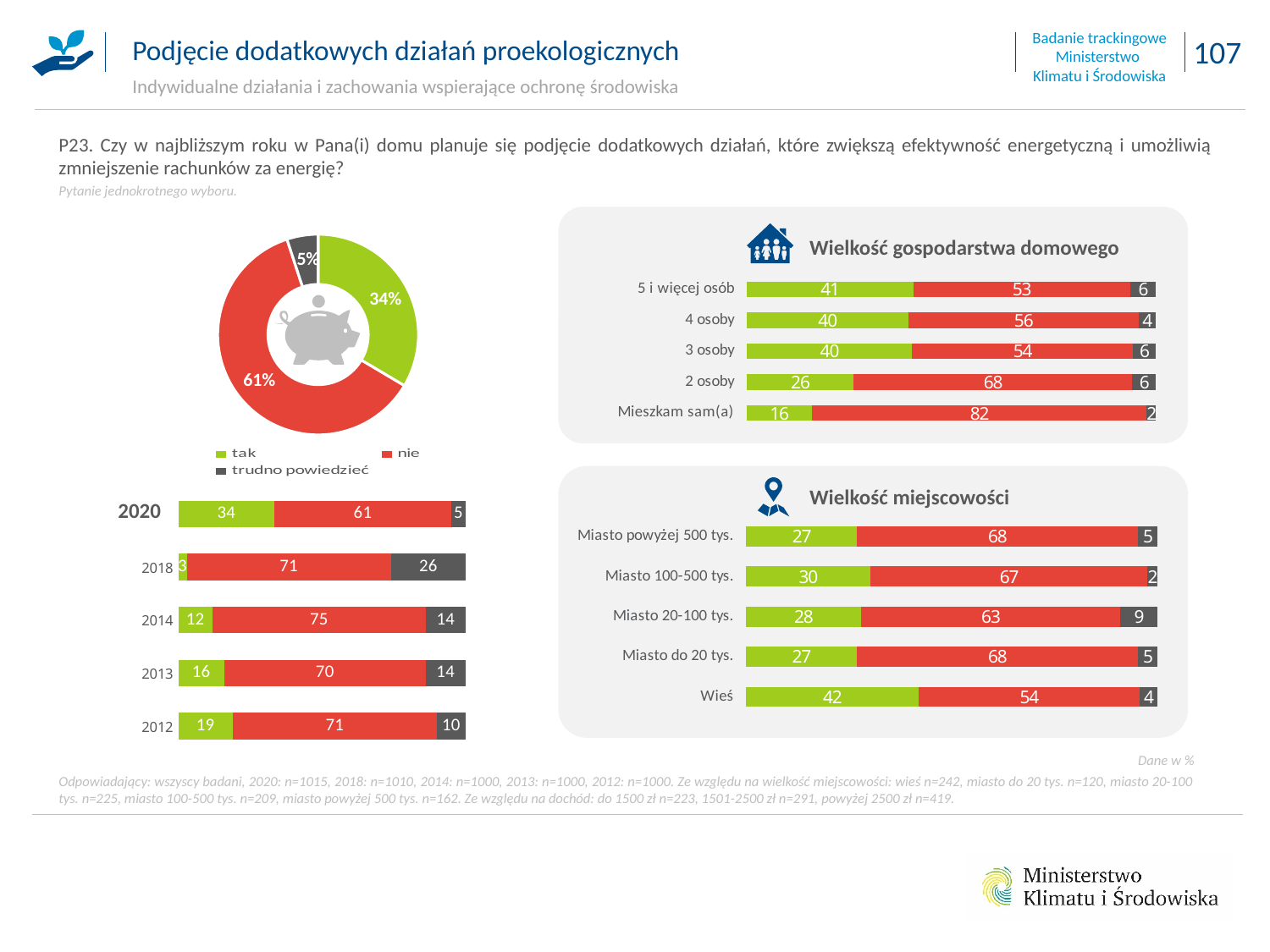
What kind of chart is the chart on the upper left showing tak / nie / trudno powiedzieć? Pie (donut) chart In the donut chart on the left, what share of respondents answered "tak"? 34% In the year-by-year bar chart on the lower left, what is the value of "nie" for 2014? 75 In the year-by-year bar chart on the lower left, which year has the highest "tak" value? 2020 In the "Wielkość gospodarstwa domowego" chart, which category has the highest red (nie) value? Mieszkam sam(a) How many series does the legend of the donut chart list? 3 In the "Wielkość gospodarstwa domowego" chart, what is the green (tak) value for "2 osoby"? 26 In the "Wielkość miejscowości" chart, what is the total of the stacked bar for "Miasto 20-100 tys."? 100 In the year-by-year bar chart on the lower left, what is the difference between the "nie" values for 2018 and 2020? 10 In the year-by-year bar chart on the lower left, how many years are shown? 5 In the donut chart on the left, what share of respondents answered "nie"? 61% In the "Wielkość miejscowości" chart, which category has the highest green (tak) value? Wieś